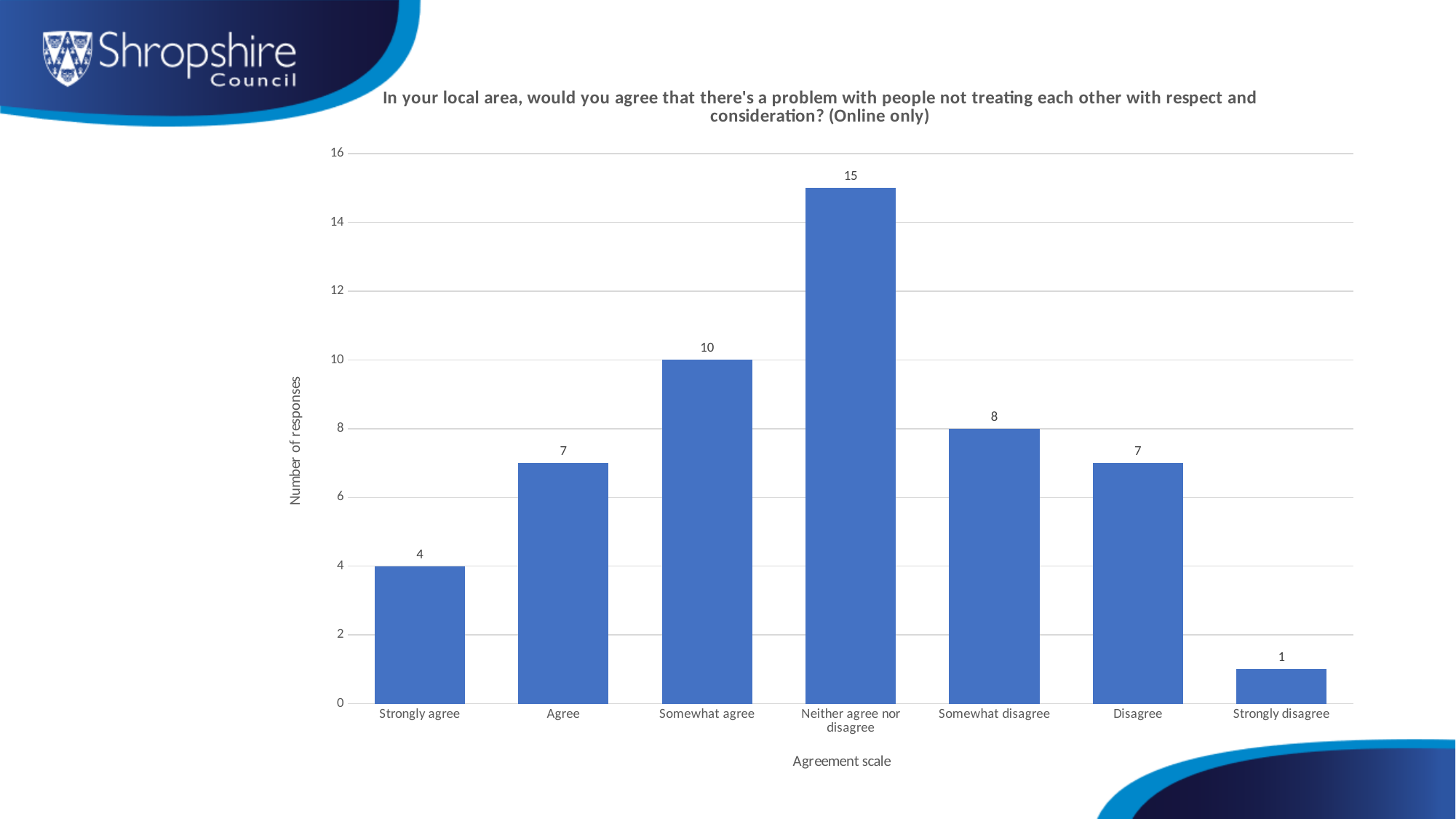
How many responses did 'Somewhat disagree' receive? 8 Which agreement category has the lowest number of responses? Strongly disagree How many agreement categories are shown on the x axis? 7 Is the value for 'Somewhat agree' greater or less than 8? greater What type of chart is shown on the slide? Bar chart Which agreement category has the highest number of responses? Neither agree nor disagree How many responses were recorded for 'Neither agree nor disagree'? 15 Which has more responses, 'Somewhat disagree' or 'Disagree'? Somewhat disagree What is the label of the y axis? Number of responses What is the label of the x axis? Agreement scale What is the difference in responses between 'Neither agree nor disagree' and 'Somewhat agree'? 5 What is the number of responses for 'Strongly agree'? 4